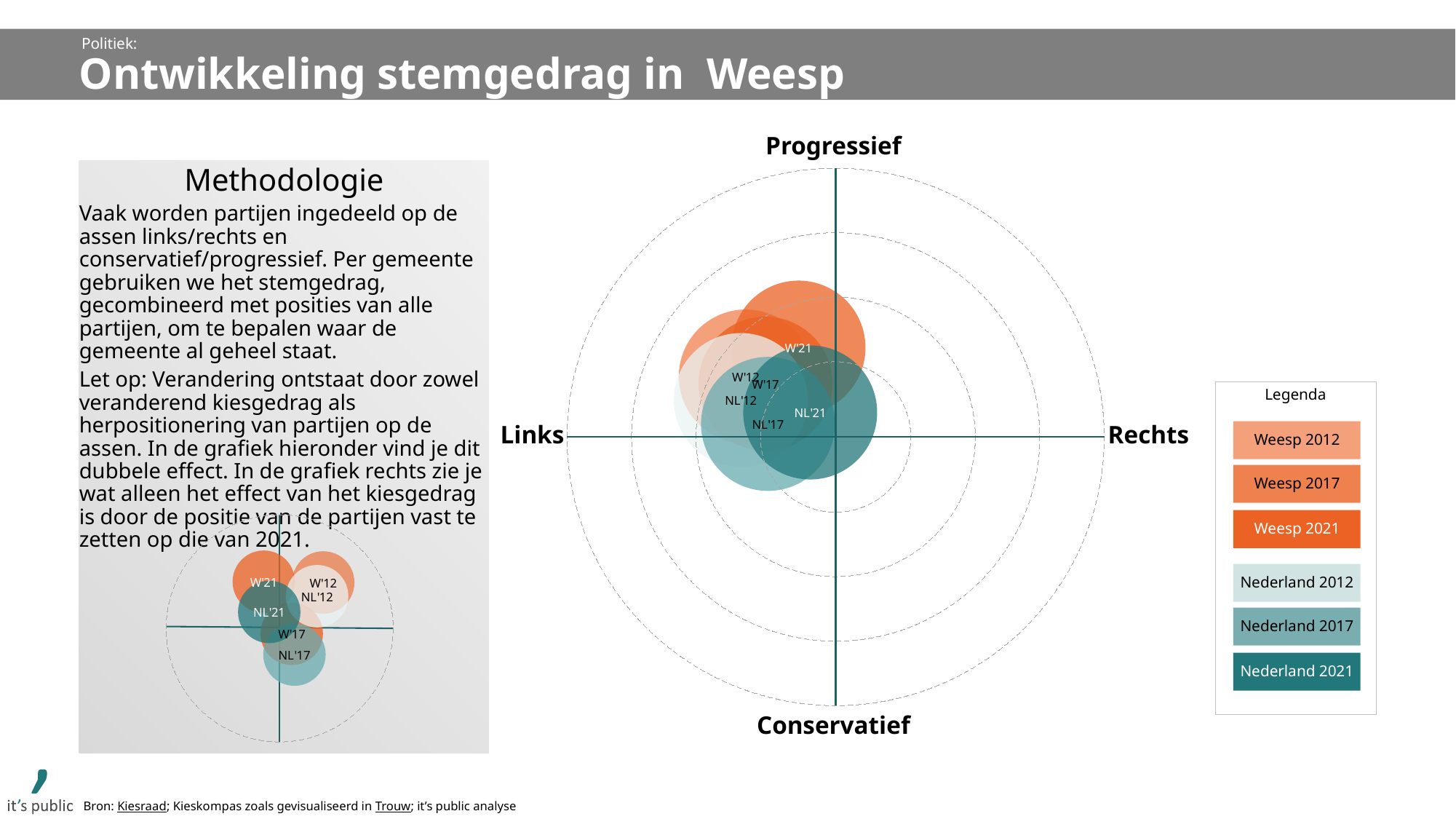
What label appears at the right end of the horizontal axis of the large chart? Rechts In the small chart inside the Methodologie box, which bubble is positioned further toward Rechts: W'12 or W'21? W'12 What label appears at the top end of the vertical axis of the large chart? Progressief What kind of chart is the large chart on the right of the slide? bubble chart Which legend entry is shown in the darkest teal colour? Nederland 2021 In the large chart, is the W'21 bubble centred on the Links side or the Rechts side of the vertical axis? Links How many labelled bubbles are plotted in the small chart inside the Methodologie box? 6 In the large chart, how many labelled bubbles are plotted? 6 How many entries does the legend (Legenda) list? 6 In the small chart inside the Methodologie box, which bubble is positioned further toward Progressief: W'21 or NL'17? W'21